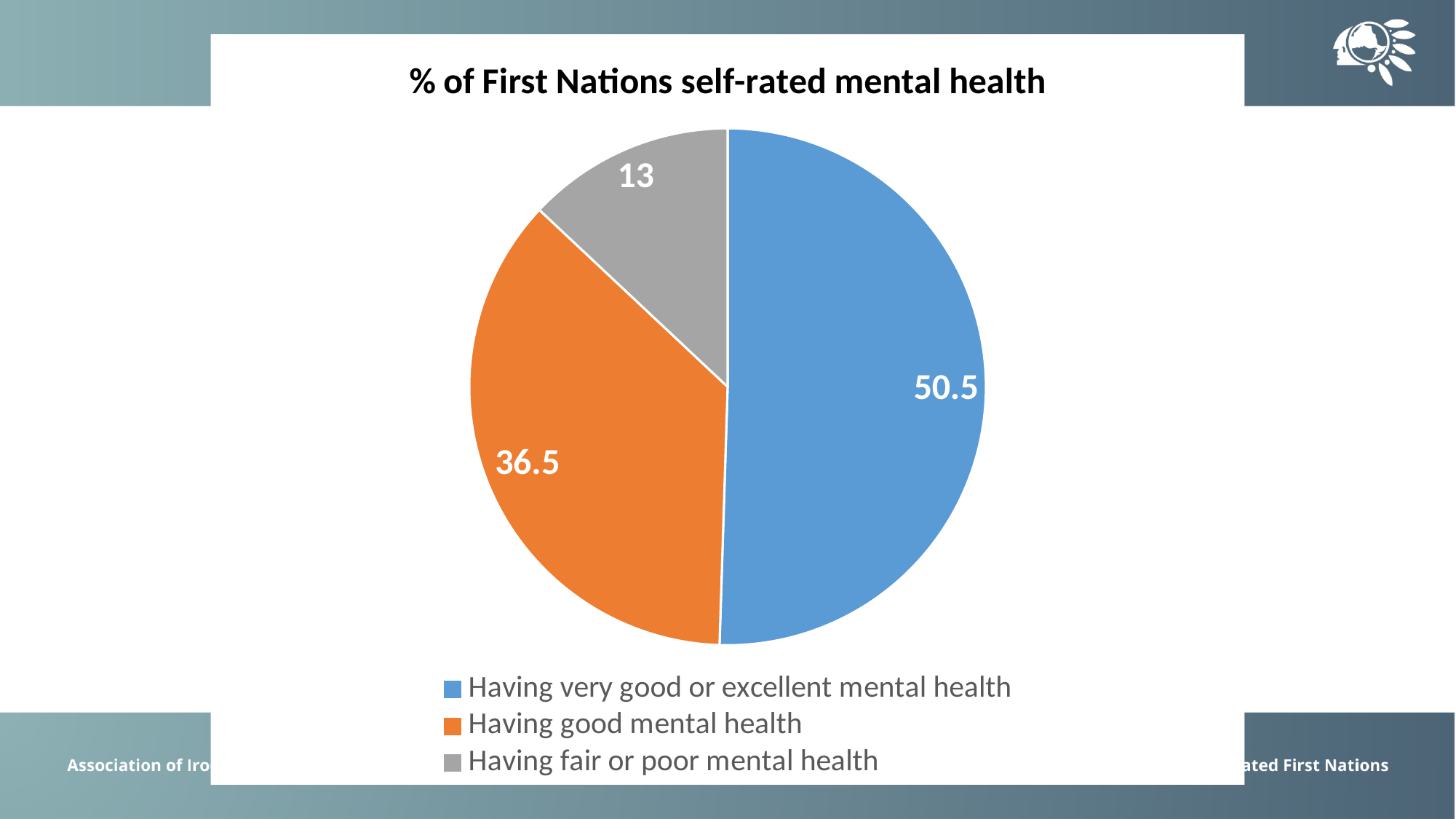
Which is larger: 'Having good mental health' or 'Having fair or poor mental health'? Having good mental health What is the value for 'Having fair or poor mental health'? 13 Which category has the largest slice? Having very good or excellent mental health How many categories does the pie chart have? 3 Which category has the smallest slice? Having fair or poor mental health What is the value for 'Having very good or excellent mental health'? 50.5 What colour is the slice for 'Having good mental health'? orange What kind of chart is shown on the slide? pie chart What is the title of the chart? % of First Nations self-rated mental health What is the difference between the values for 'Having good mental health' and 'Having fair or poor mental health'? 23.5 What is the value for 'Having good mental health'? 36.5 What is the difference between the values for 'Having very good or excellent mental health' and 'Having good mental health'? 14